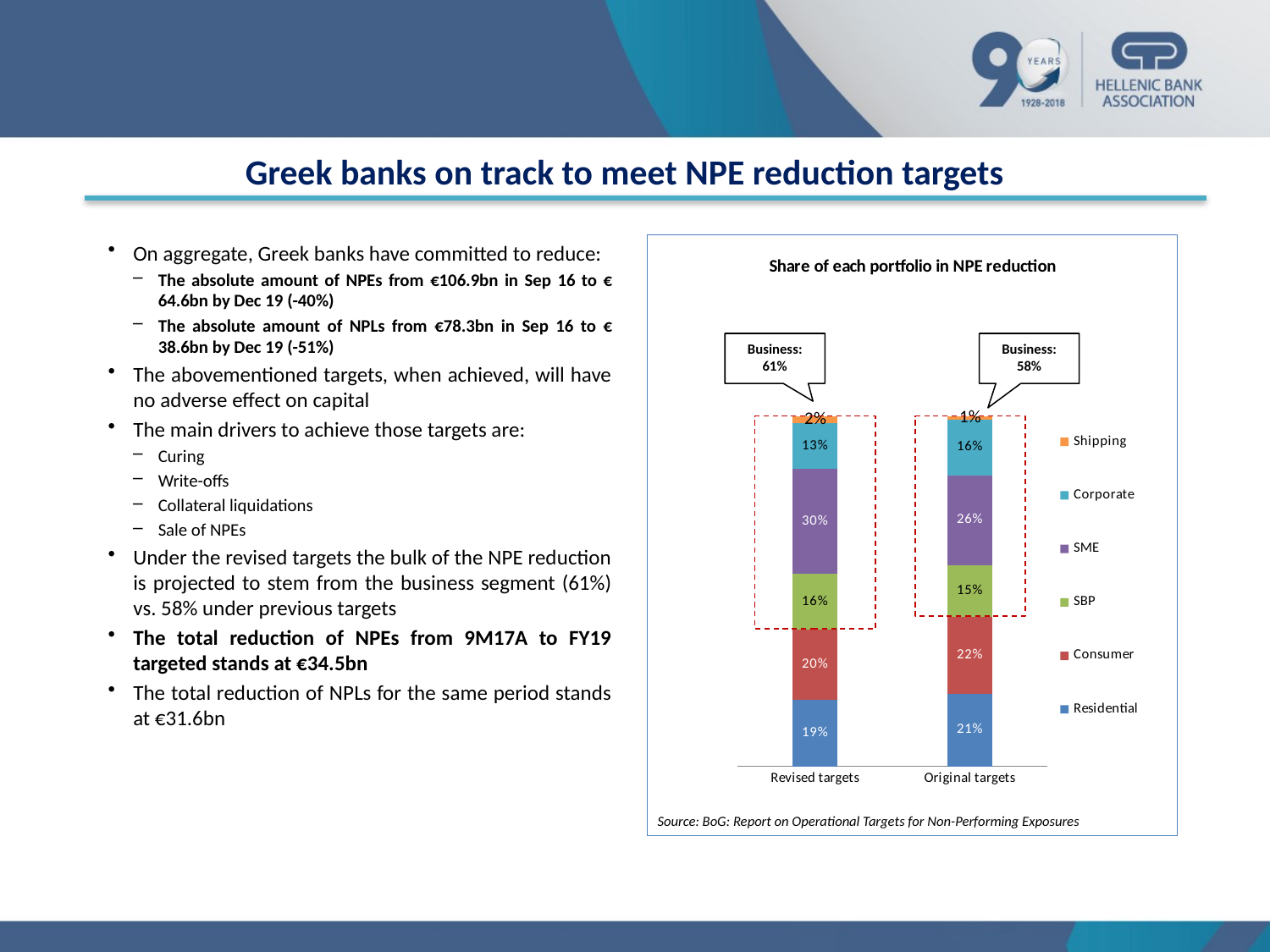
What is the Corporate share under the Original targets? 16% What is the difference between the SME share under Revised targets and under Original targets? 4 percentage points What kind of chart is shown on the slide? Stacked bar chart What is the SME share under the Revised targets? 30% How many series does the chart legend list? 6 What is the Shipping share under the Original targets? 1% How many bars (categories) are plotted in the chart? 2 Is the Consumer share larger under Revised targets or Original targets? Original targets What is the title of the chart? Share of each portfolio in NPE reduction Which portfolio has the largest share in the Revised targets bar? SME What is the Residential share under the Revised targets? 19% Which portfolio has the smallest share in the Original targets bar? Shipping